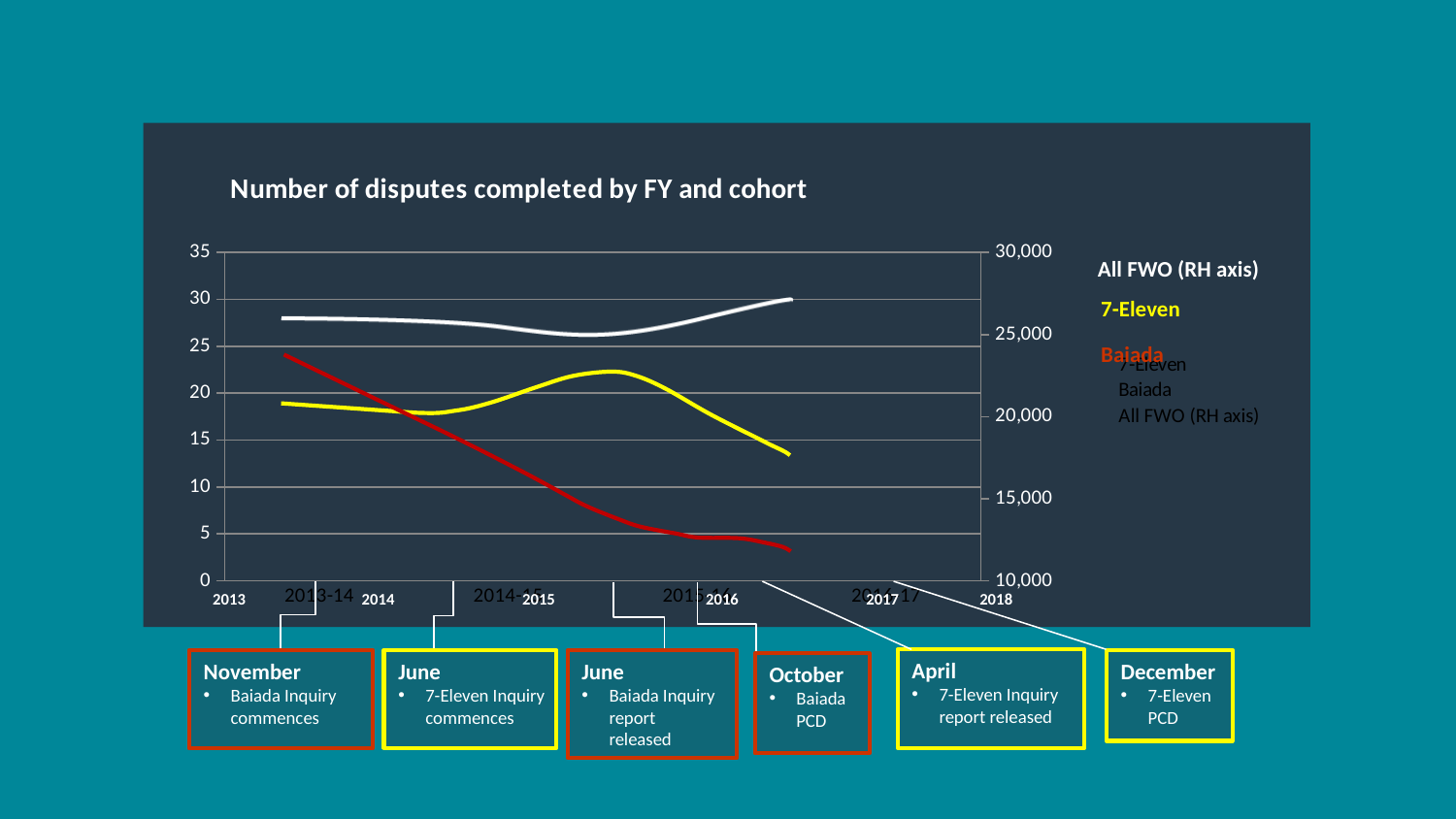
In which financial year is the Baiada line at its highest? 2013-14 Which series is plotted against the right-hand axis? All FWO In which financial year is the 7-Eleven line at its lowest? 2016-17 Is the value for Baiada in 2016-17 greater or less than 5? less Is the value for 7-Eleven in 2015-16 greater or less than 20? greater Is the value for 7-Eleven in 2016-17 greater or less than 15? less How many financial years are plotted along the x axis? 4 In 2013-14, which is larger: the Baiada value or the 7-Eleven value? Baiada What kind of chart is shown on the slide? line chart How many series does the legend list? 3 Does the Baiada line rise or fall from 2013-14 to 2016-17? fall